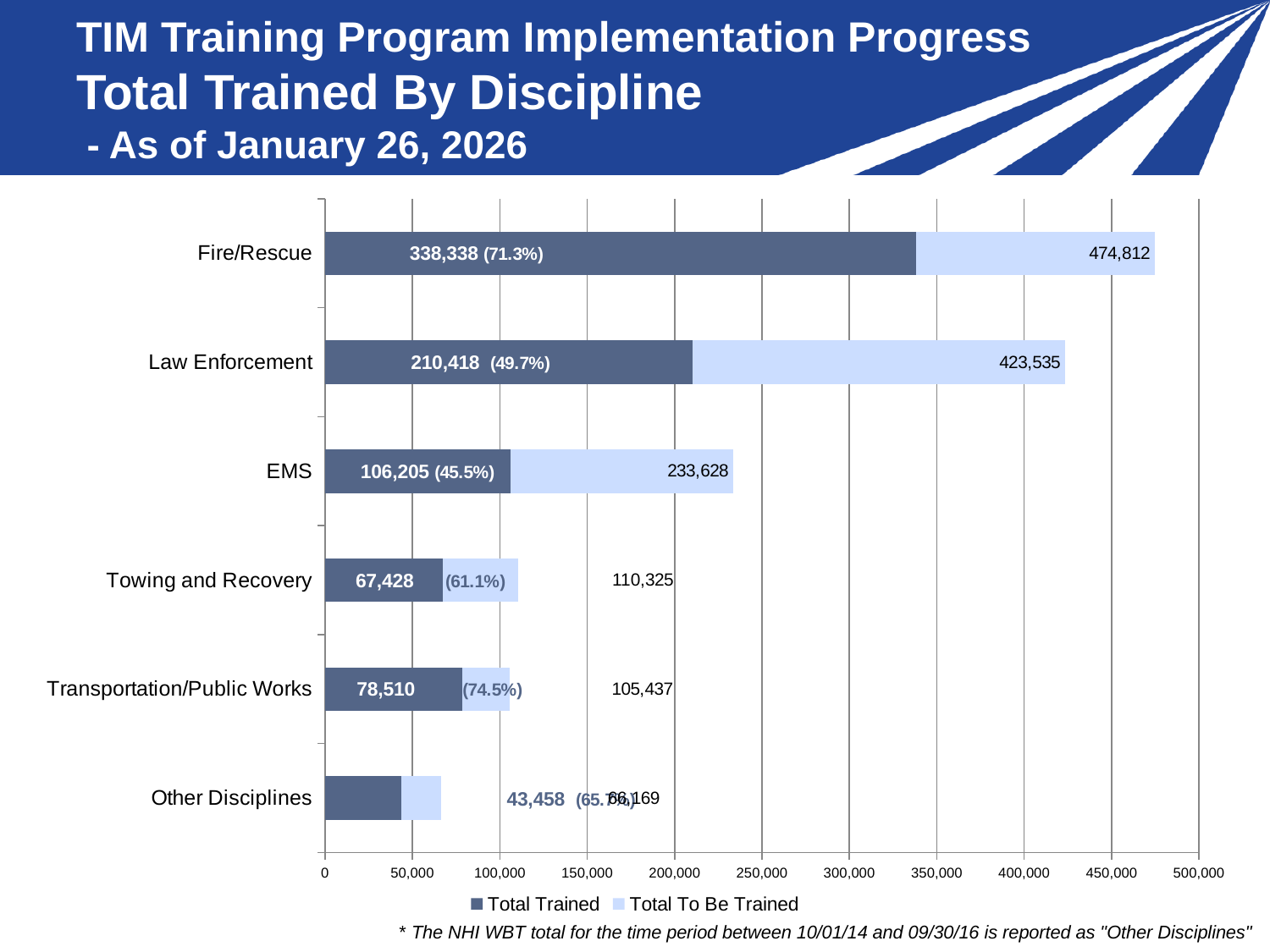
What is the Total Trained value for Fire/Rescue? 338,338 How many disciplines (categories) are shown on the chart? 6 What kind of chart is shown on the slide? bar chart Which discipline has the highest Total Trained value? Fire/Rescue Is the value at the end of the Law Enforcement bar greater or less than 400,000? greater What is the difference between the Total Trained values for Fire/Rescue and Law Enforcement? 127,920 Which discipline has the lowest Total Trained value? Other Disciplines What is the value labeled at the end of the EMS bar? 233,628 How many series does the legend list? 2 What is the Total Trained value for Law Enforcement? 210,418 Which has a larger Total Trained value, Towing and Recovery or Transportation/Public Works? Transportation/Public Works What percentage is shown for Transportation/Public Works? 74.5%